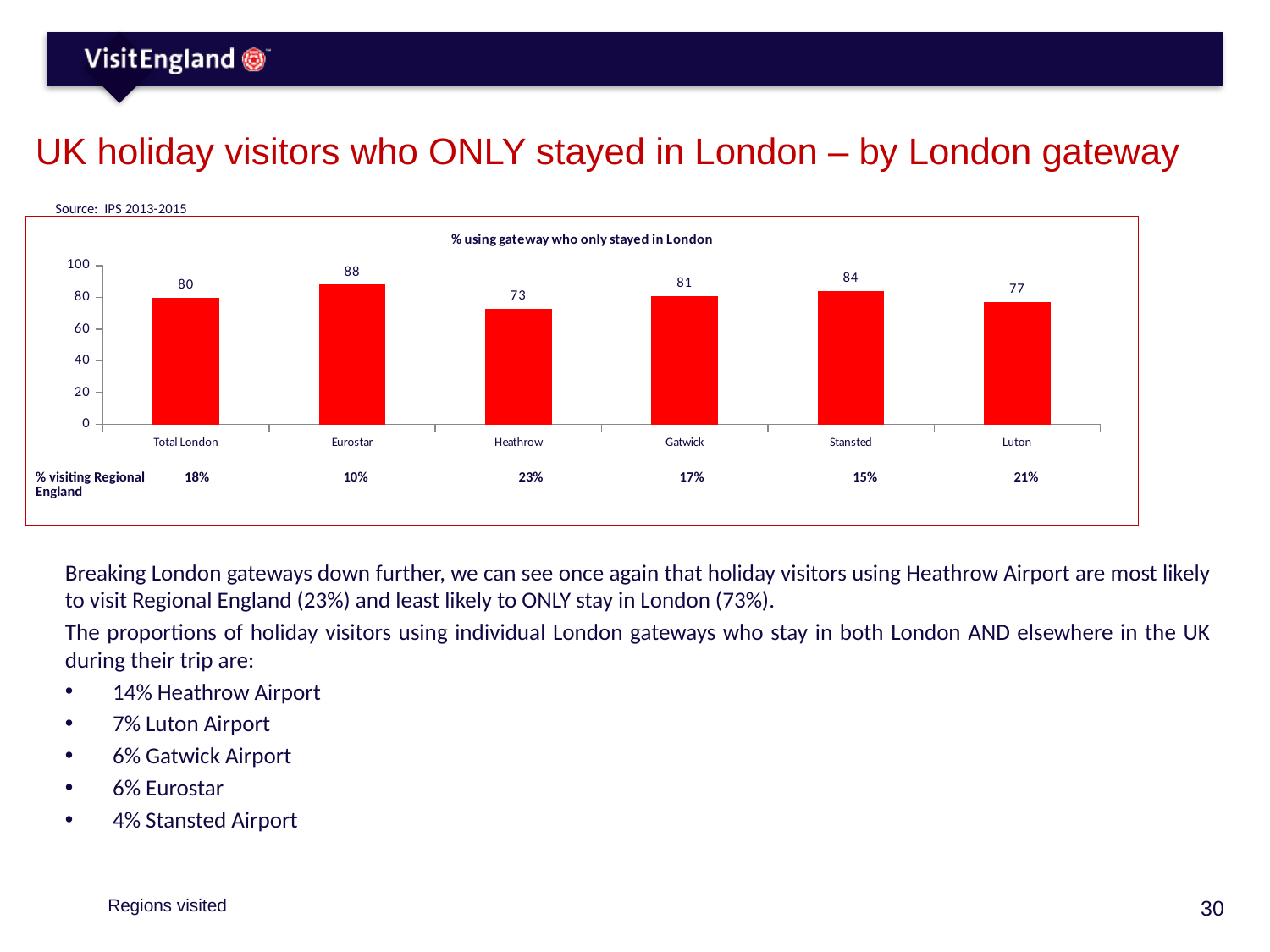
What is the title of the chart? % using gateway who only stayed in London Which gateway has the highest percentage of users who only stayed in London? Eurostar How many categories are shown on the x axis of the chart? 6 Which gateway has the lowest percentage of users who only stayed in London? Heathrow What is the value for Eurostar in the chart? 88 What is the value for Total London in the chart? 80 What is the difference between the values for Stansted and Luton? 7 What is the '% visiting Regional England' figure shown under Heathrow in the chart? 23% What is the value for Heathrow in the chart? 73 What kind of chart is shown on the slide? Bar chart What colour are the bars in the chart? Red Which is larger, the value for Gatwick or the value for Luton? Gatwick